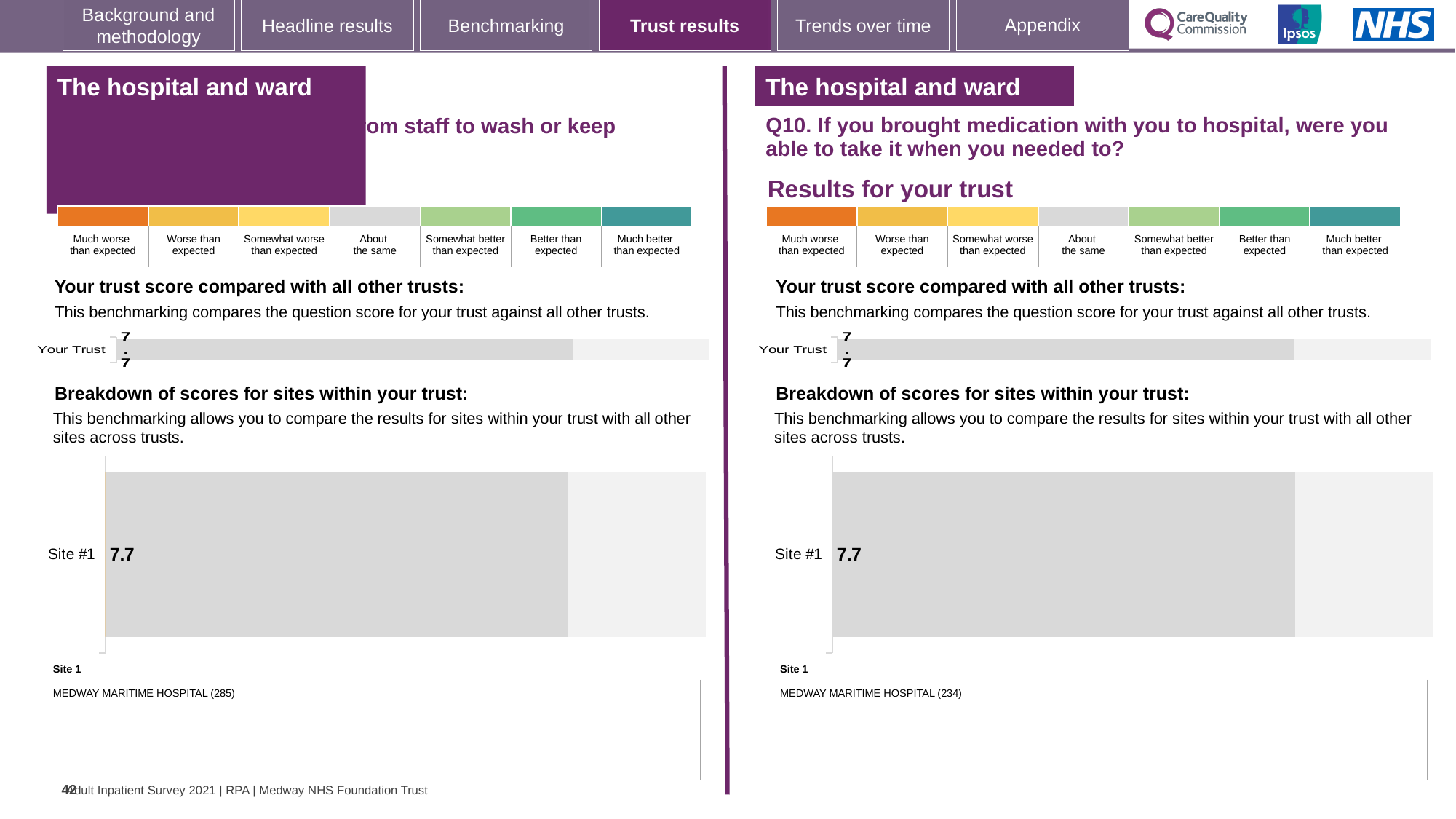
In the right-hand panel (Q10), how many sites are plotted in the 'Breakdown of scores for sites within your trust' chart? 1 In the left-hand panel, what is the score shown for Your Trust in the 'Your trust score compared with all other trusts' chart? 7.7 In the right-hand panel (Q10), what is the label of the single bar in the 'Your trust score compared with all other trusts' chart? Your Trust In the left-hand panel, what score is shown for Site #1 in the 'Breakdown of scores for sites within your trust' chart? 7.7 In the left-hand panel, how many sites are plotted in the 'Breakdown of scores for sites within your trust' chart? 1 What kind of chart is used to show the Site #1 score in the right-hand panel (Q10)? Bar chart In the right-hand panel (Q10), what is the score shown for Your Trust in the 'Your trust score compared with all other trusts' chart? 7.7 How many categories does the colour scale above the charts in the right-hand panel (Q10) show, from 'Much worse than expected' to 'Much better than expected'? 7 In the right-hand panel (Q10), what score is shown for Site #1 in the 'Breakdown of scores for sites within your trust' chart? 7.7 What is the difference between the Site #1 score in the left-hand panel and the Site #1 score in the right-hand panel (Q10)? 0.0 In the right-hand panel (Q10), what is the difference between the Your Trust score and the Site #1 score? 0.0